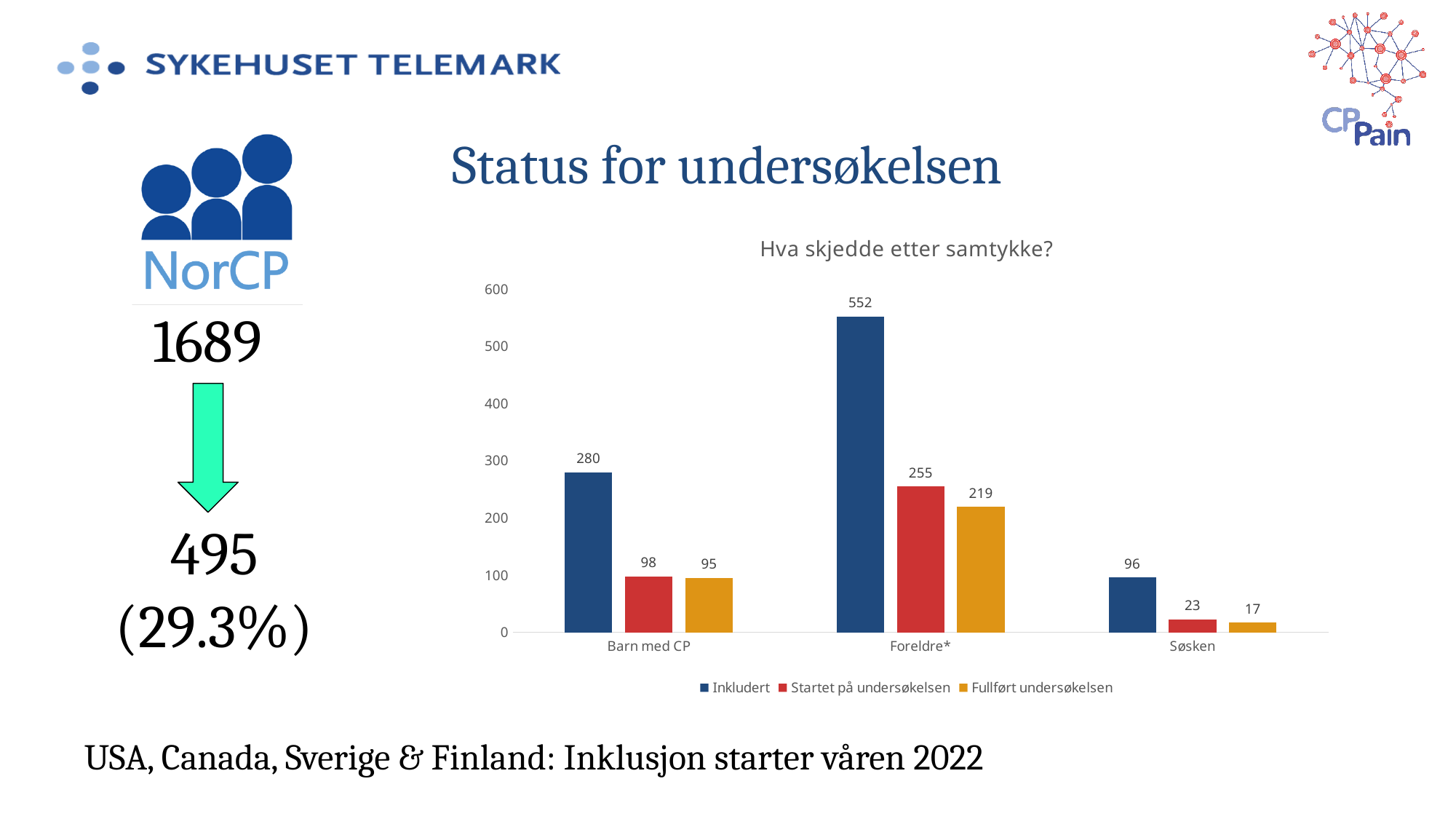
How many categories are shown on the x axis? 3 What kind of chart is shown on the slide? Bar chart Which category has the highest Inkludert value? Foreldre* What is the value for Startet på undersøkelsen in the Søsken category? 23 What is the title of the chart? Hva skjedde etter samtykke? What is the difference between Inkludert and Startet på undersøkelsen for Barn med CP? 182 How many series does the legend list? 3 Is the value for Fullført undersøkelsen in the Foreldre* category greater or less than 200? greater Which is larger: Startet på undersøkelsen for Foreldre* or Inkludert for Barn med CP? Inkludert for Barn med CP What is the value for Inkludert in the Foreldre* category? 552 What is the value for Fullført undersøkelsen in the Barn med CP category? 95 Which category has the lowest Fullført undersøkelsen value? Søsken